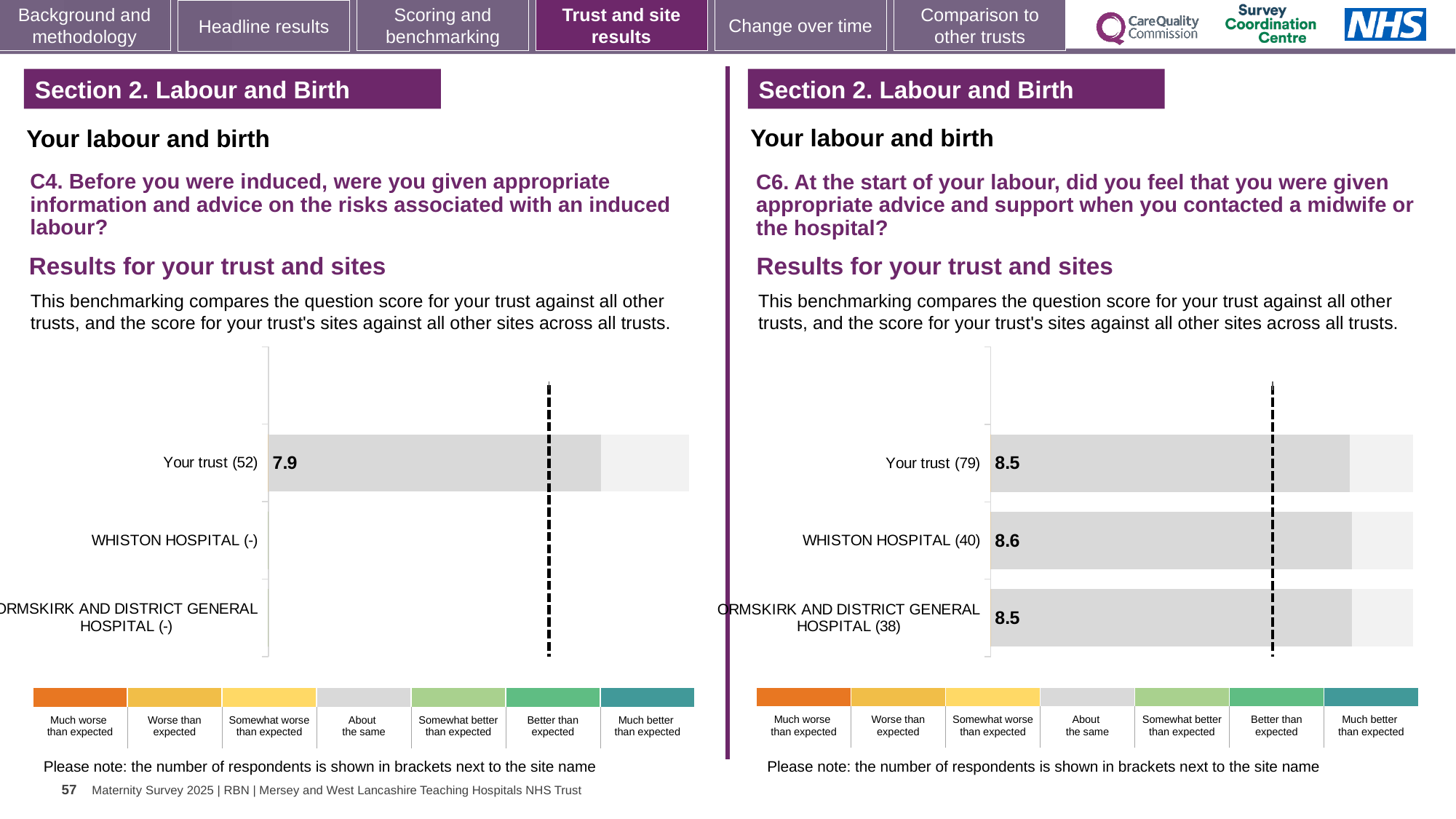
In the left chart (C4), which categories have no score shown? WHISTON HOSPITAL and ORMSKIRK AND DISTRICT GENERAL HOSPITAL In the right chart (C6), what is the score for WHISTON HOSPITAL? 8.6 In the right chart (C6), what is the difference between the scores for WHISTON HOSPITAL and Your trust? 0.1 In the left chart (C4), what is the score for Your trust? 7.9 In the right chart (C6), what is the score for ORMSKIRK AND DISTRICT GENERAL HOSPITAL? 8.5 In the left chart (C4), how many respondents are shown in brackets for Your trust? 52 What kind of chart is used in the right chart (C6)? Bar chart How many categories are listed on the y axis of the left chart (C4)? 3 How many benchmark bands are shown in the colour key below each chart? 7 In the right chart (C6), what is the score for Your trust? 8.5 In the right chart (C6), which category has the highest score? WHISTON HOSPITAL In the right chart (C6), how many respondents are shown in brackets for Your trust? 79